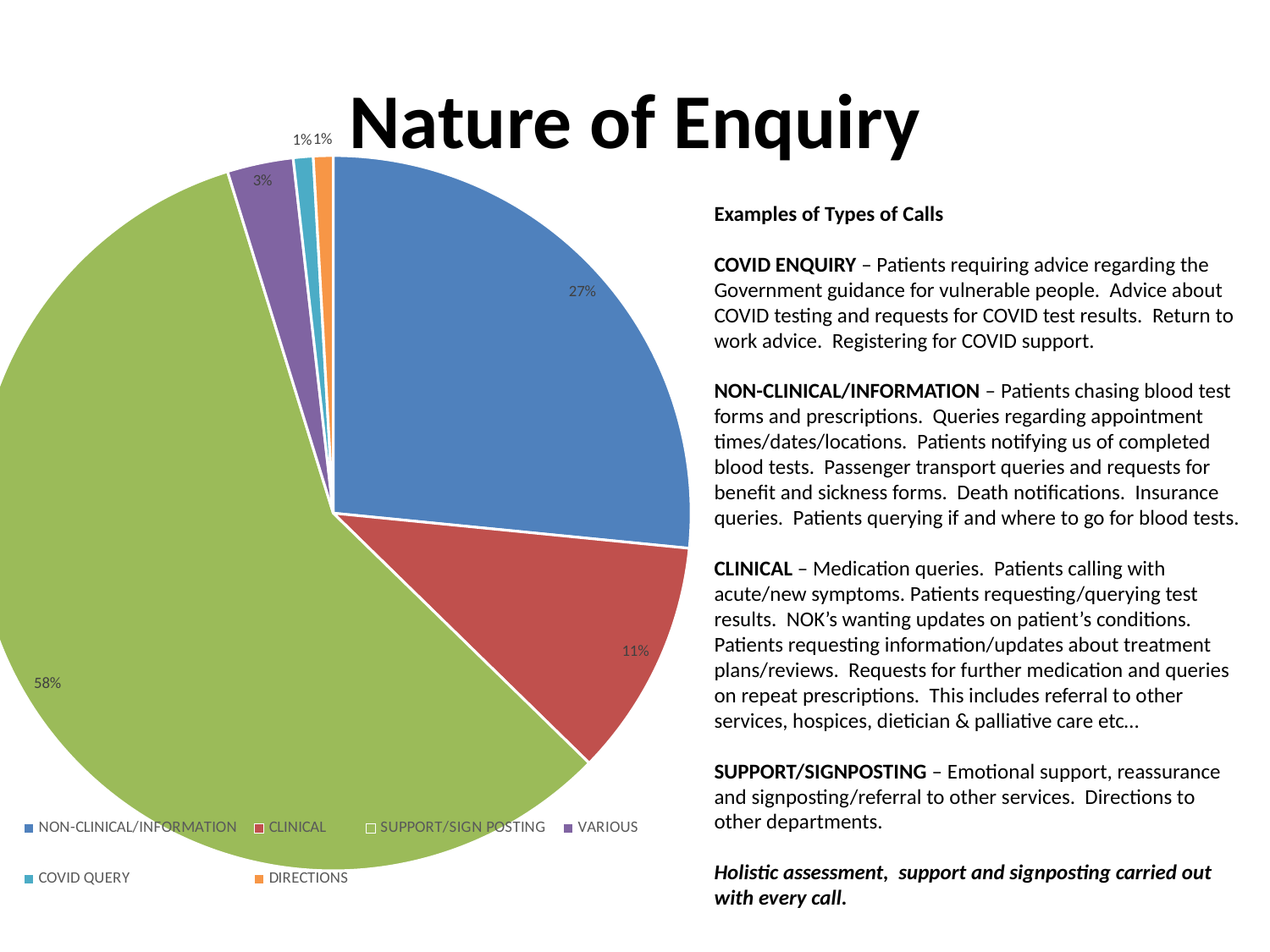
What share of the pie is SUPPORT/SIGN POSTING? 58% What is the difference in percentage points between SUPPORT/SIGN POSTING and NON-CLINICAL/INFORMATION? 31% What colour is the CLINICAL slice? red What is the title of the chart? Nature of Enquiry What kind of chart is shown on the slide? pie chart How many categories does the legend list? 6 What share of the pie is COVID QUERY? 1% What share of the pie is NON-CLINICAL/INFORMATION? 27% Which is larger, NON-CLINICAL/INFORMATION or CLINICAL? NON-CLINICAL/INFORMATION Which category has the largest slice of the pie? SUPPORT/SIGN POSTING